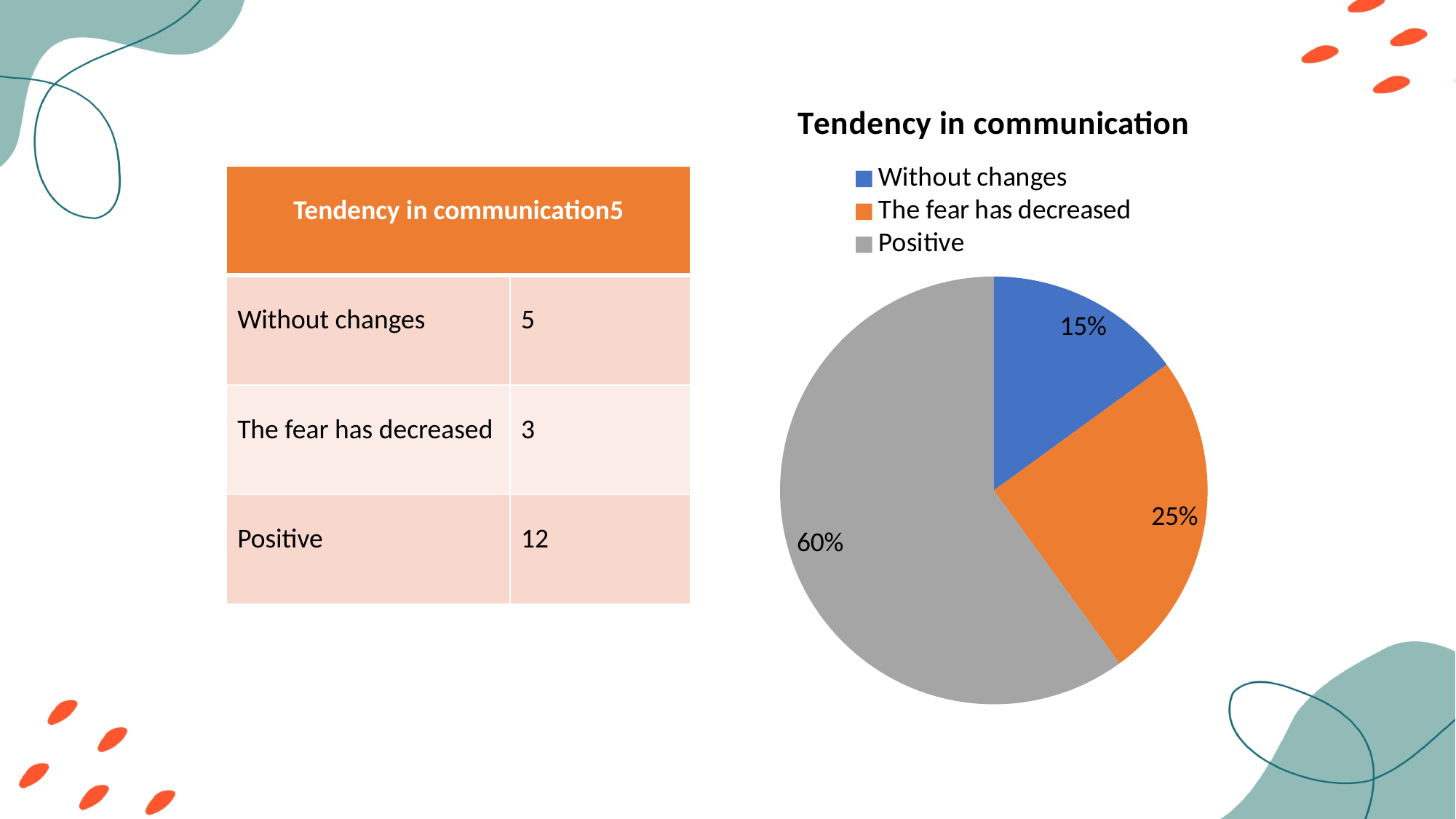
How many slices does the pie chart have? 3 What share of the pie chart does the slice for The fear has decreased represent? 25% What is the difference in percentage points between the slice for The fear has decreased and the Without changes slice? 10 What is the title of the chart? Tendency in communication How many entries does the legend of the pie chart list? 3 Which category has the largest slice in the pie chart? Positive What share of the pie chart does the Without changes slice represent? 15% What is the difference in percentage points between the Positive slice and the slice for The fear has decreased? 35 What share of the pie chart does the Positive slice represent? 60% Which category has the smallest slice in the pie chart? Without changes Which slice is larger: Without changes or The fear has decreased? The fear has decreased What kind of chart is shown on the slide? Pie chart